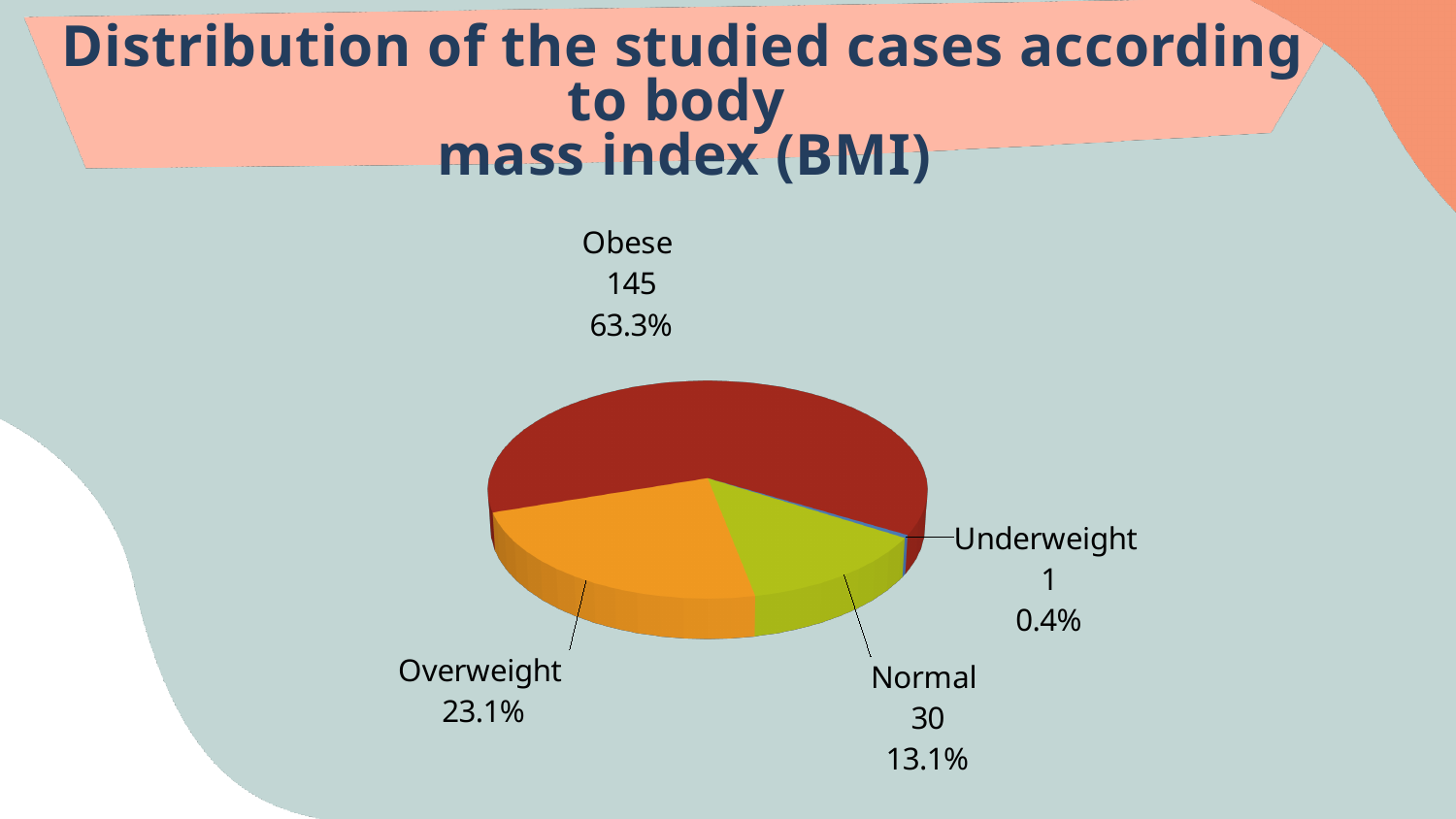
Which category has a larger share, Overweight or Normal? Overweight What is the title of the chart on the slide? Distribution of the studied cases according to body mass index (BMI) Which BMI category has the largest share of cases? Obese How many cases are in the Obese category? 145 How many categories does the pie chart show? 4 What kind of chart is shown on the slide? pie chart How many more cases are Obese than Normal? 115 What percentage of the studied cases are Obese? 63.3% What percentage of the studied cases are Underweight? 0.4% How many cases are in the Normal category? 30 What percentage of the studied cases are Overweight? 23.1% Which BMI category has the smallest share of cases? Underweight